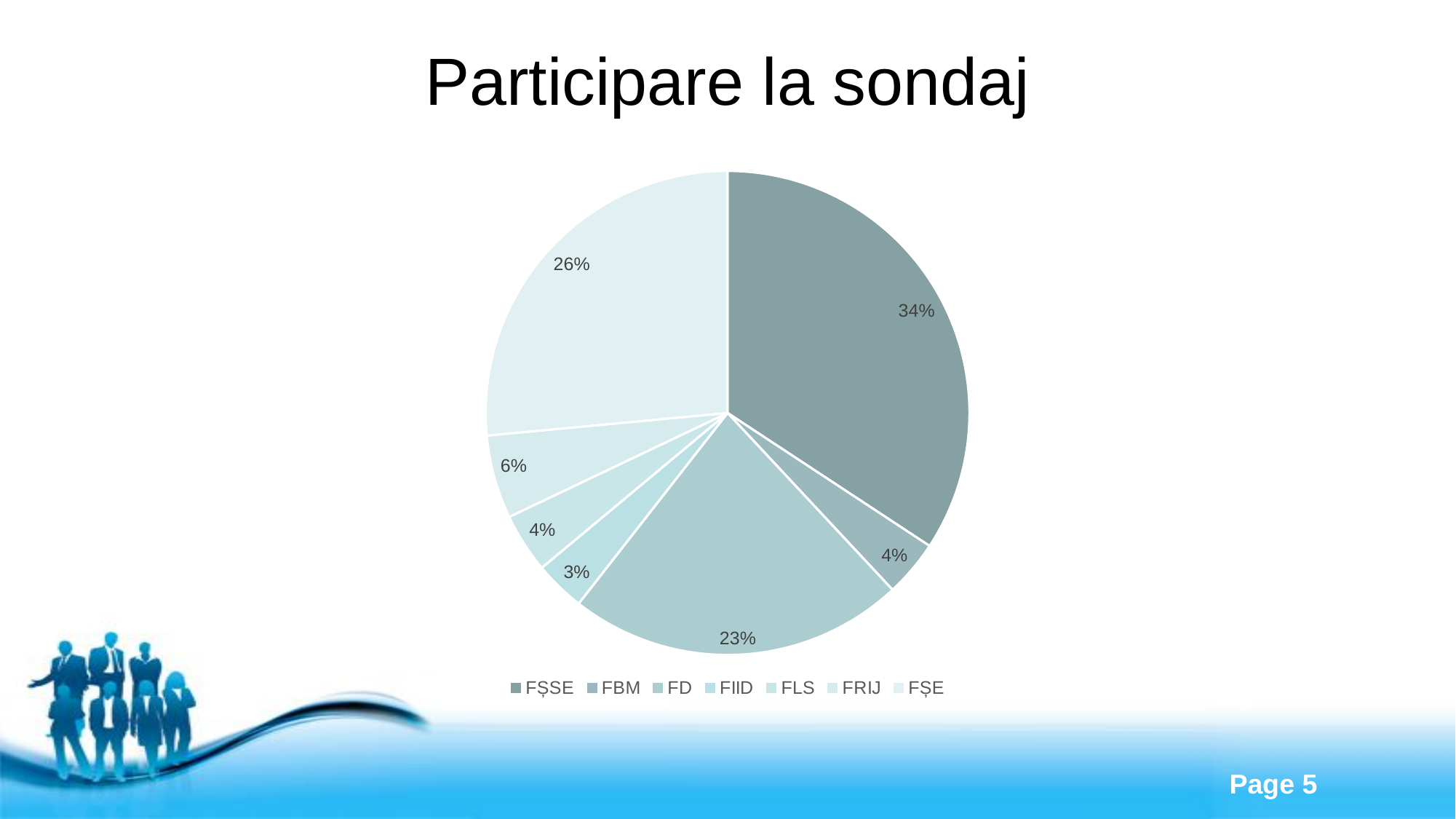
What kind of chart is shown on the slide? Pie chart What is the title of the slide containing the chart? Participare la sondaj What is the difference between the shares of FȘSE and FȘE? 8% How many categories does the pie chart show? 7 What share of the pie does FD represent? 23% What share of the pie does FȘSE represent? 34% Which category has the largest slice of the pie? FȘSE Which category has the smallest slice of the pie? FIID What is the value shown for FRIJ? 6% What is the value shown for FIID? 3% Which is larger, the share of FD or the share of FȘE? FȘE What share of the pie does FȘE represent? 26%